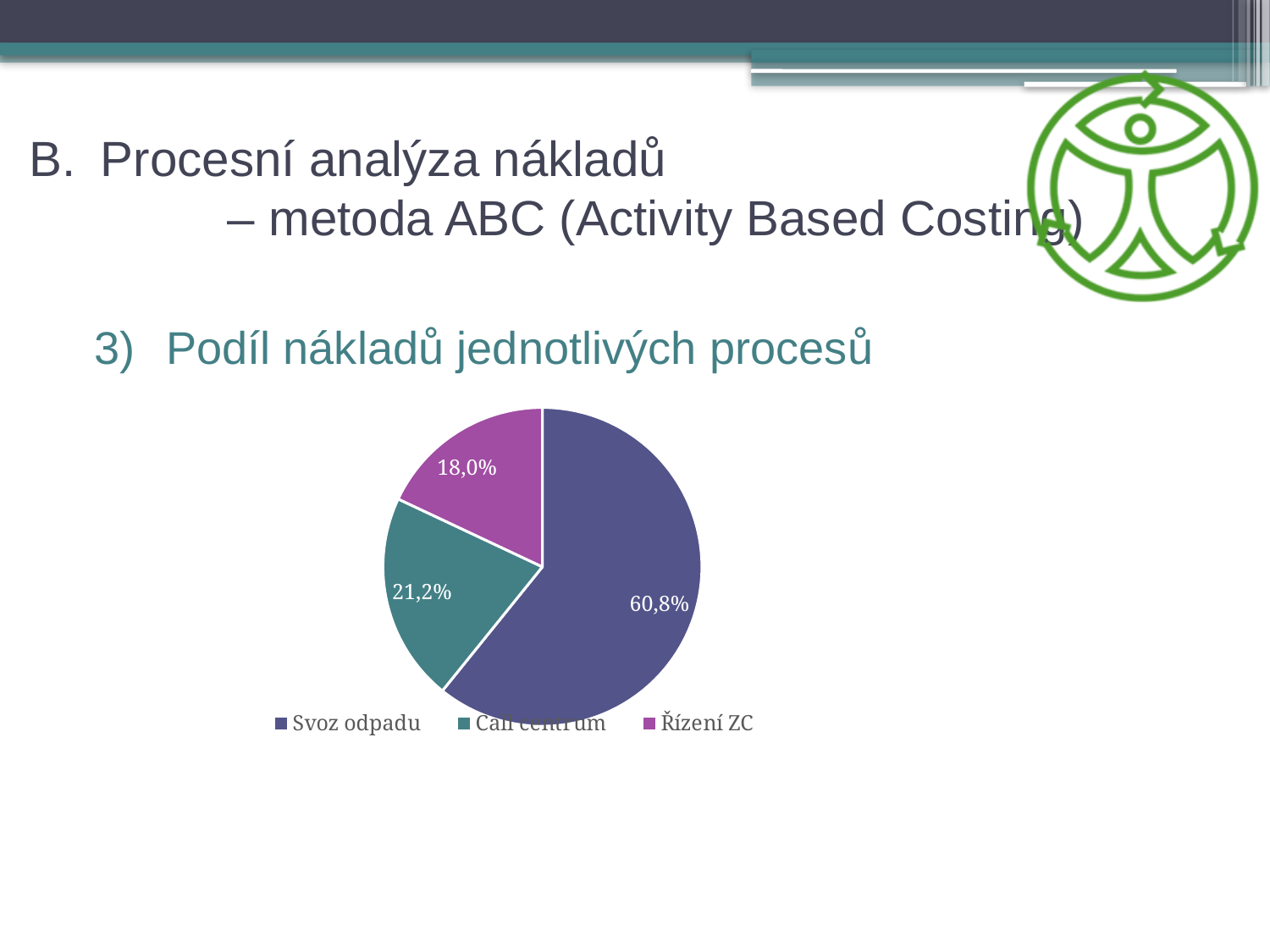
What kind of chart is shown on the slide? Pie chart What share of the pie does Svoz odpadu have? 60,8% Which is larger, the share for Call centrum or the share for Řízení ZC? Call centrum Which category is shown in teal in the pie chart? Call centrum What share of the pie does Řízení ZC have? 18,0% What is the difference in percentage points between Svoz odpadu and Call centrum? 39,6 What share of the pie does Call centrum have? 21,2% Which category has the largest slice of the pie? Svoz odpadu Which category is shown in purple/magenta in the pie chart? Řízení ZC Which category has the smallest slice of the pie? Řízení ZC How many categories does the pie chart show? 3 What is the difference in percentage points between Call centrum and Řízení ZC? 3,2